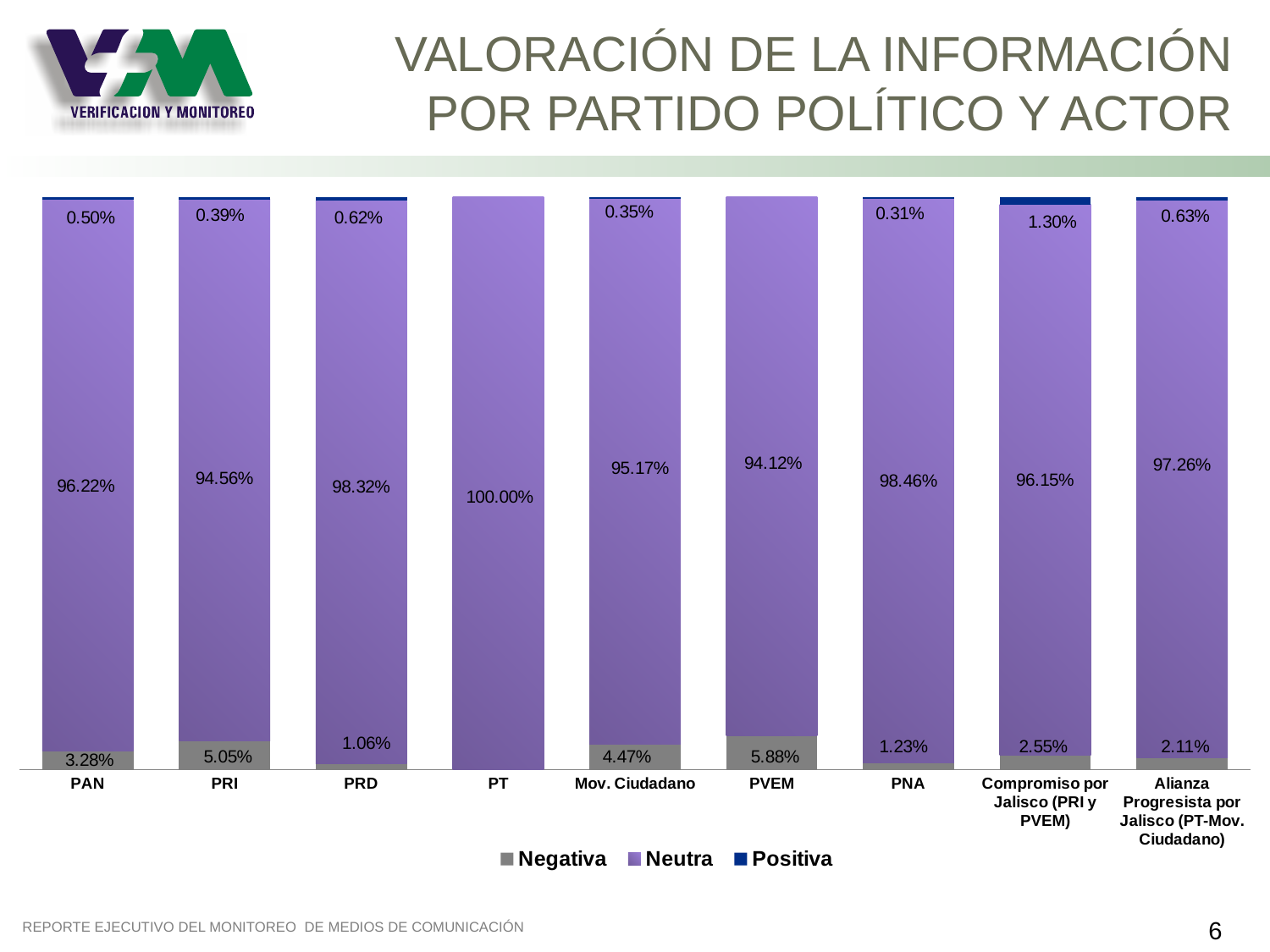
Which has a larger Neutra value, PNA or Mov. Ciudadano? PNA Which category has the highest Positiva value? Compromiso por Jalisco (PRI y PVEM) Which category has the lowest Neutra value? PVEM Which category has the highest Negativa value? PVEM How many series does the legend list? 3 What kind of chart is shown on the slide? Stacked bar chart What is the Positiva value for Compromiso por Jalisco (PRI y PVEM)? 1.30% What is the Negativa value for PRI? 5.05% What is the Neutra value for PAN? 96.22% What is the difference between the Negativa values for PVEM and PRD? 4.82% How many categories are shown on the x axis? 9 What is the Neutra value for PT? 100.00%